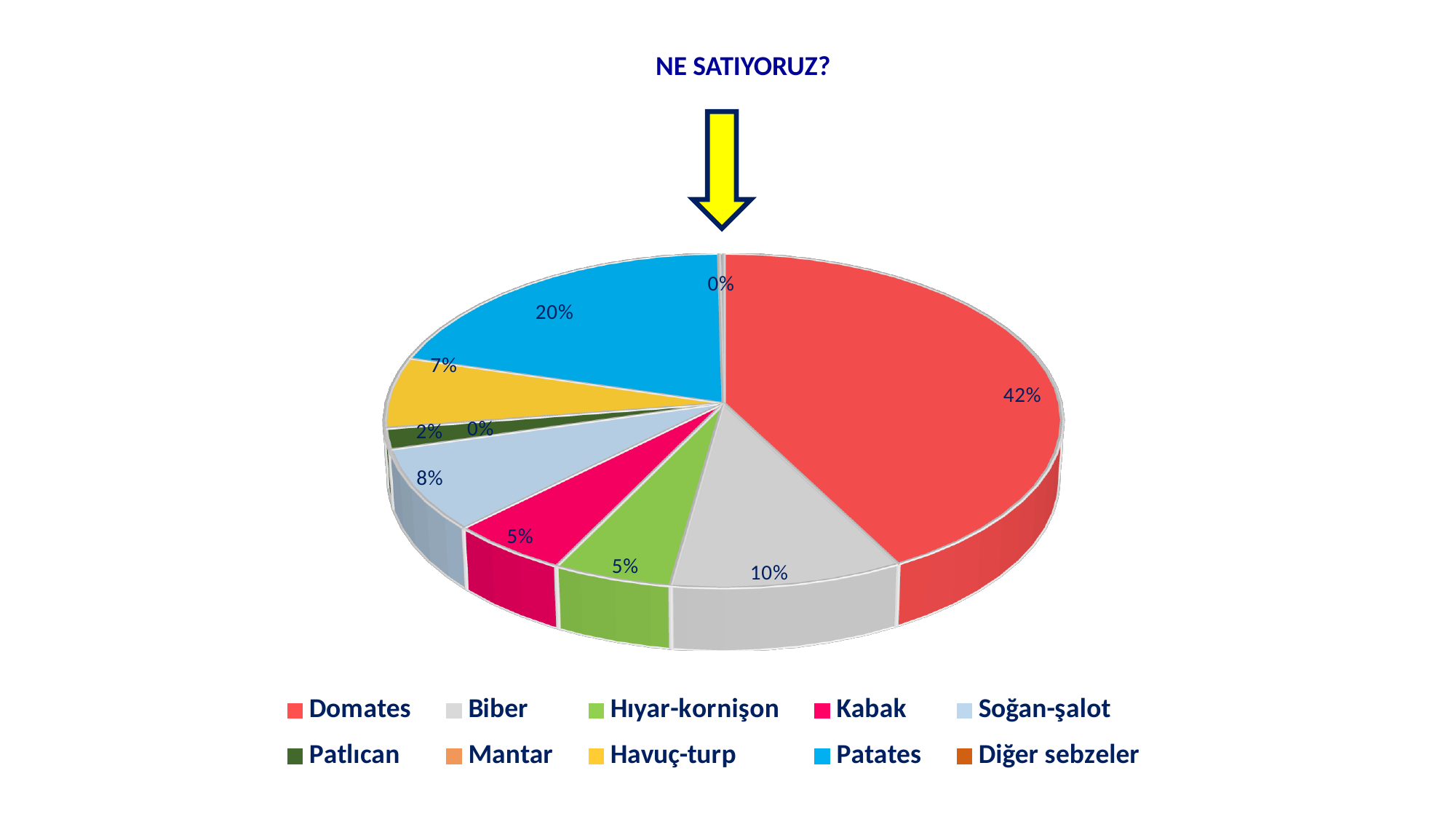
What percentage is shown for Biber? 10% What is the difference between the Domates and Patates percentages? 22% What is the title of the chart? NE SATIYORUZ? Which category has the largest slice of the pie? Domates What percentage is shown for Soğan-şalot? 8% What share of the pie does Domates have? 42% What type of chart is shown on the slide? pie chart What percentage is shown for Havuç-turp? 7% Which is larger, the share for Biber or the share for Soğan-şalot? Biber What percentage is shown for Patlıcan? 2% What percentage is shown for Patates? 20% How many categories are listed in the legend? 10